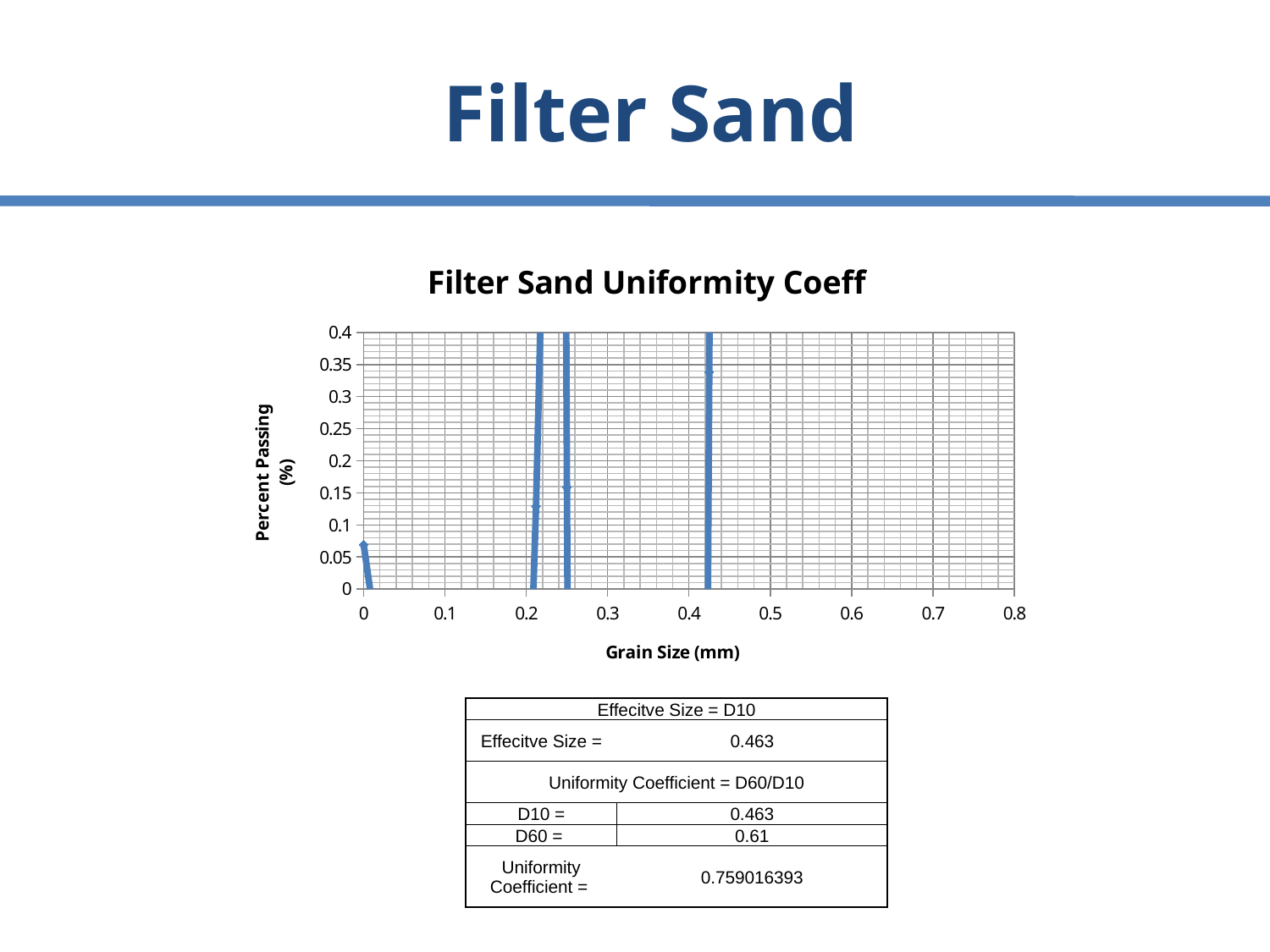
Is the grain size at which the rightmost vertical line of the chart is plotted greater or less than 0.3? greater What is the title of the chart? Filter Sand Uniformity Coeff What is the label on the x axis of the chart? Grain Size (mm) What kind of chart is shown on the slide? line chart Is the grain size at which the leftmost tall vertical line of the chart is plotted greater or less than 0.3? less